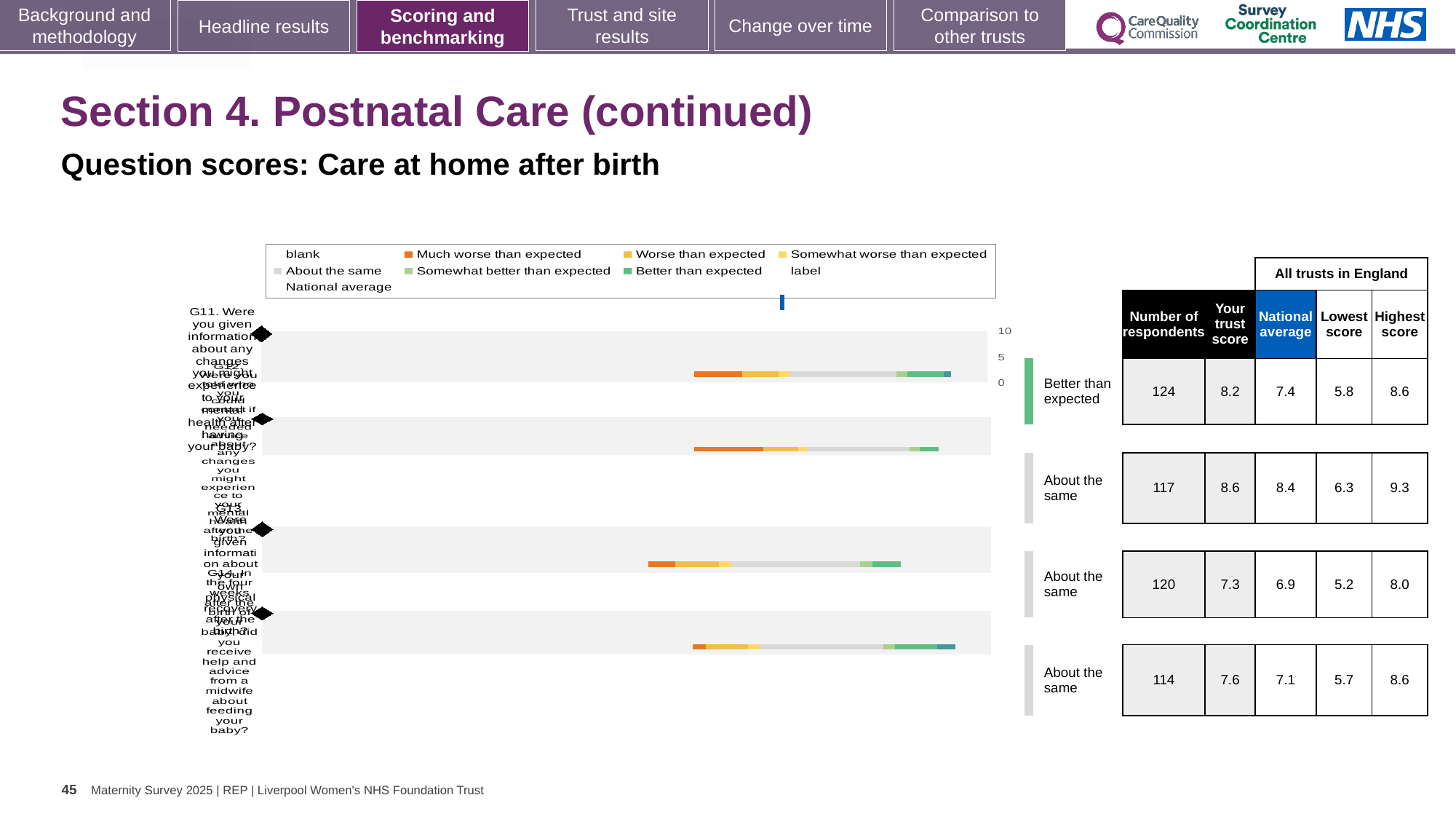
What is the national average for the second question row in the table? 8.4 What is the highest score among all trusts in England for the fourth (bottom) question row? 8.6 What colour in the legend represents 'Much worse than expected'? orange How many question rows (bars) are plotted in the chart? 4 What kind of chart is shown on the slide? bar chart How many respondents are listed for the third question row? 120 What benchmark category is shown for the first (top) question row? Better than expected What is the difference between the trust score and the national average for the first (top) question row? 0.8 Which question row has the highest 'Your trust score'? the second row (8.6) For the second question row, which is larger: the trust score or the national average? the trust score (8.6) What is the 'Your trust score' for the first (top) question row in the table? 8.2 Which question row has the lowest 'Your trust score'? the third row (7.3)